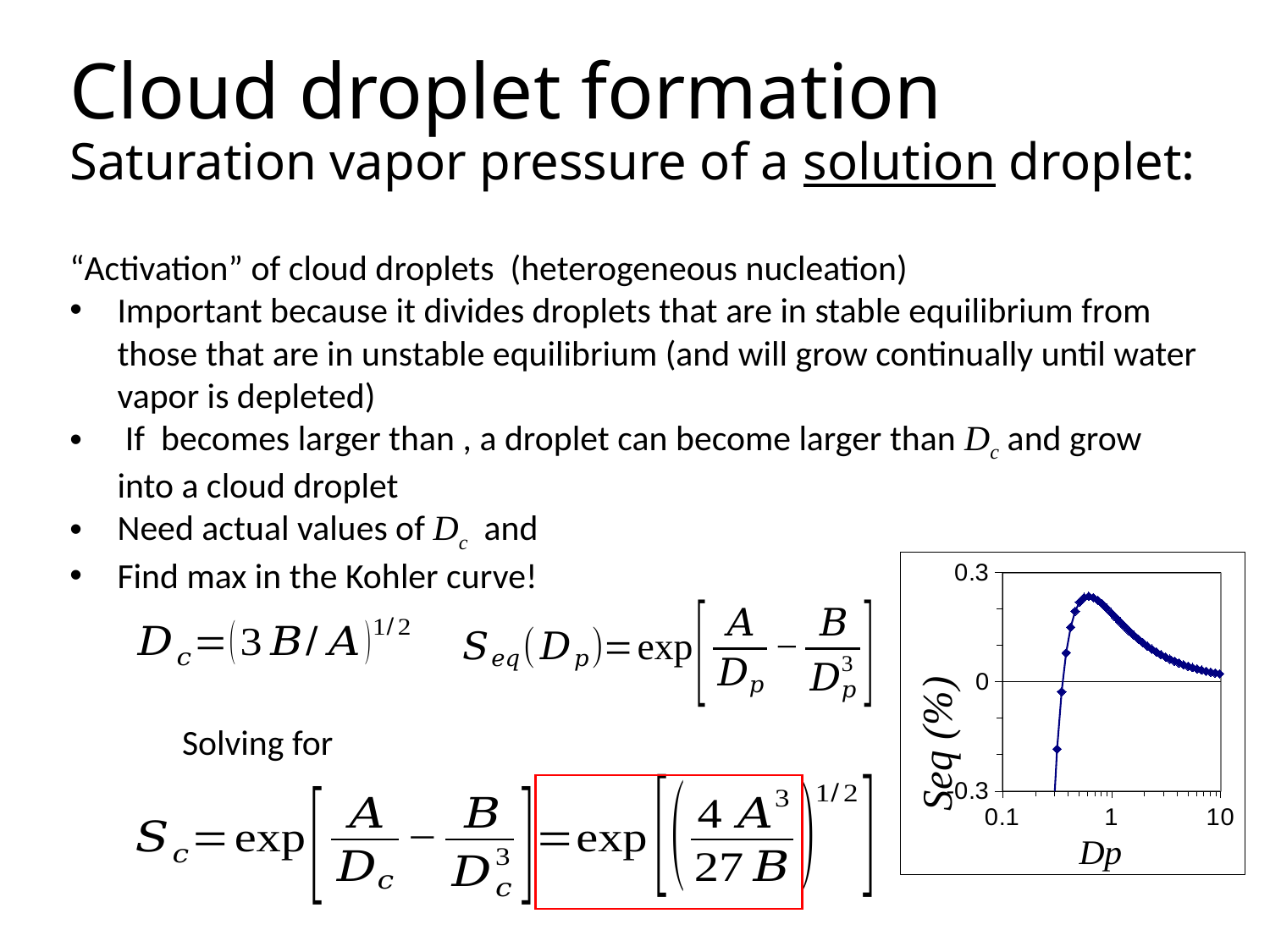
Is the value of Seq (%) at Dp = 10 greater or less than 0? greater Is the value of Seq (%) at Dp = 10 greater or less than 0.3? less What kind of chart is shown on the slide? line chart Is the peak value of the Seq (%) curve greater or less than 0.3? less Between Dp = 0.1 and the peak of the curve, do the values of Seq (%) rise or fall as Dp increases? rise After reaching its maximum, do the values of Seq (%) rise or fall as Dp increases? fall How many data series are plotted in the chart? 1 What is the label of the y axis of the chart? Seq (%) What is the label of the x axis of the chart? Dp Which is larger: the value of Seq (%) at Dp = 1 or at Dp = 10? Dp = 1